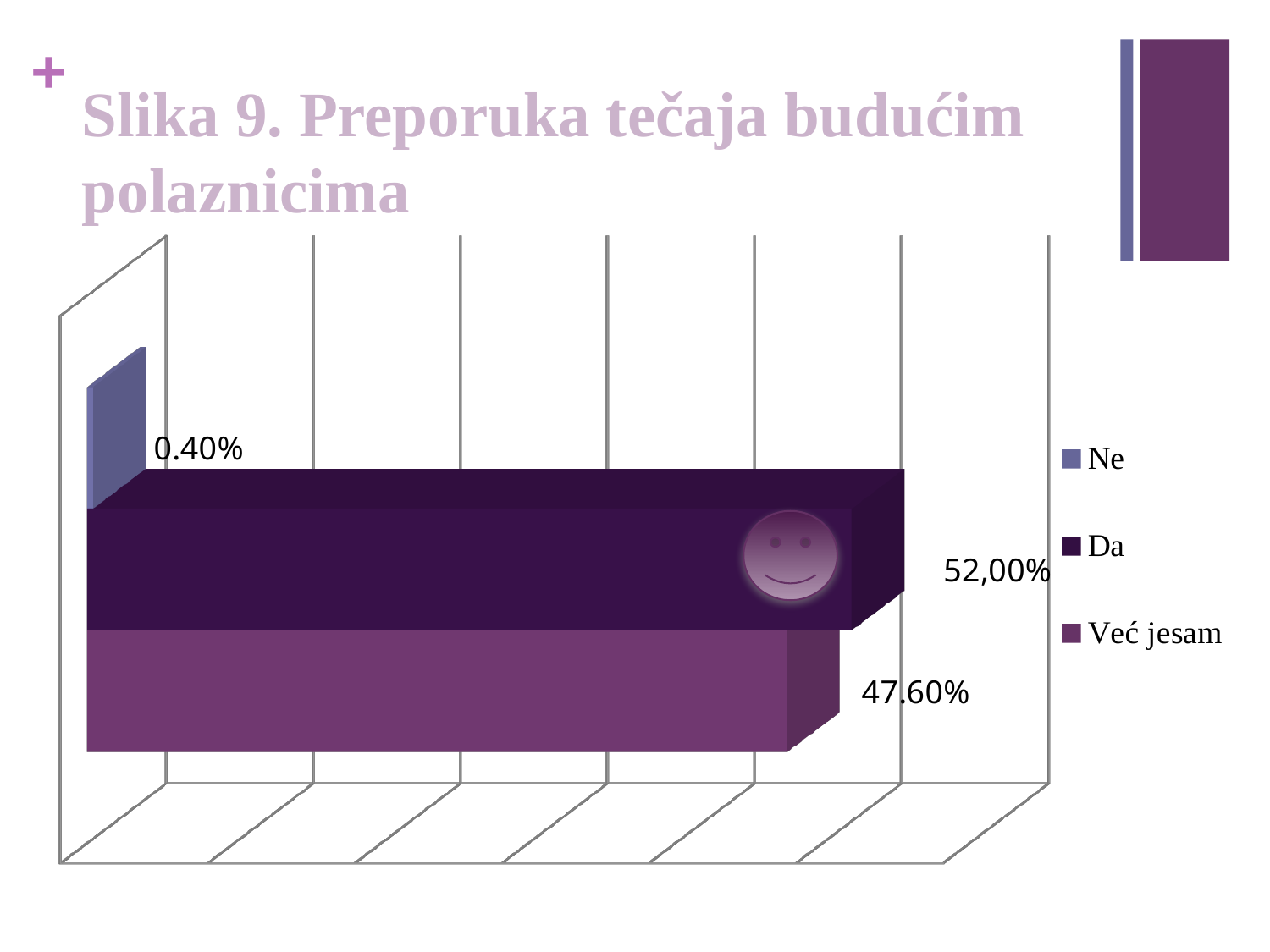
Which is larger, the value for Da or the value for Već jesam? Da What is the title of the slide? Slika 9. Preporuka tečaja budućim polaznicima What is the value for Ne? 0.40% How many series does the legend list? 3 Which category has the lowest value? Ne What kind of chart is shown on the slide? bar chart Which legend entry is listed first? Ne Which category has the highest value? Da What is the value for Da? 52,00% What is the difference between the value for Da and the value for Već jesam? 4.40% What is the value for Već jesam? 47.60% Which is larger, the value for Ne or the value for Već jesam? Već jesam